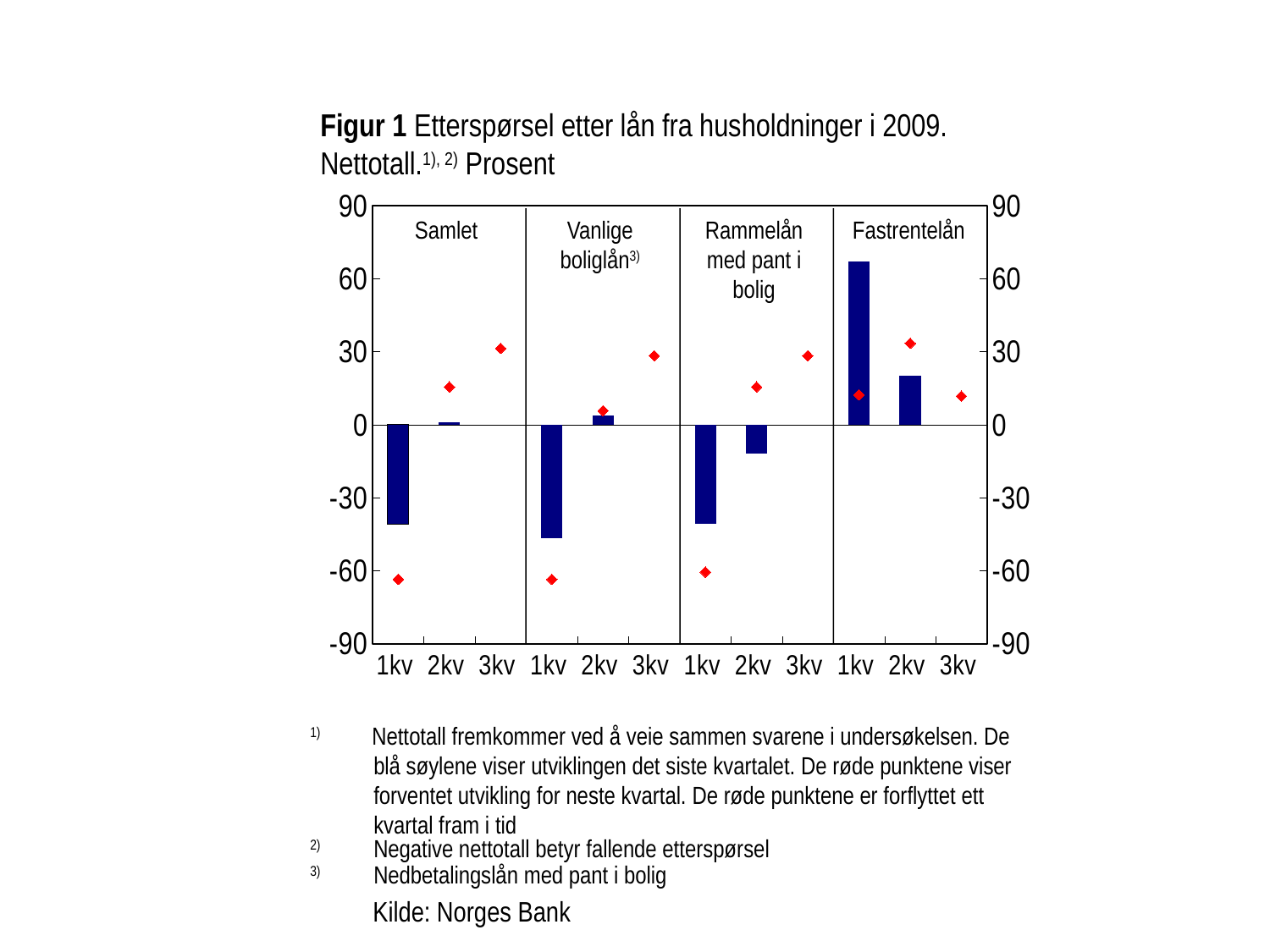
Is the value of the 1kv bar in the Samlet panel greater or less than -30? less How many loan categories (panels) does the chart show? 4 Is the value of the 1kv bar in the Vanlige boliglån panel greater or less than -30? less What colour are the bars in the chart? Blue Is the value of the 2kv bar in the Rammelån med pant i bolig panel greater or less than -30? greater Which panel has the highest 1kv bar? Fastrentelån Which panel has the lowest 1kv bar? Vanlige boliglån In the Fastrentelån panel, which bar is larger, 1kv or 2kv? 1kv What kind of chart is shown on the slide? Combination chart: bars with red point markers In the Samlet panel, do the red points rise or fall from 1kv to 3kv? rise